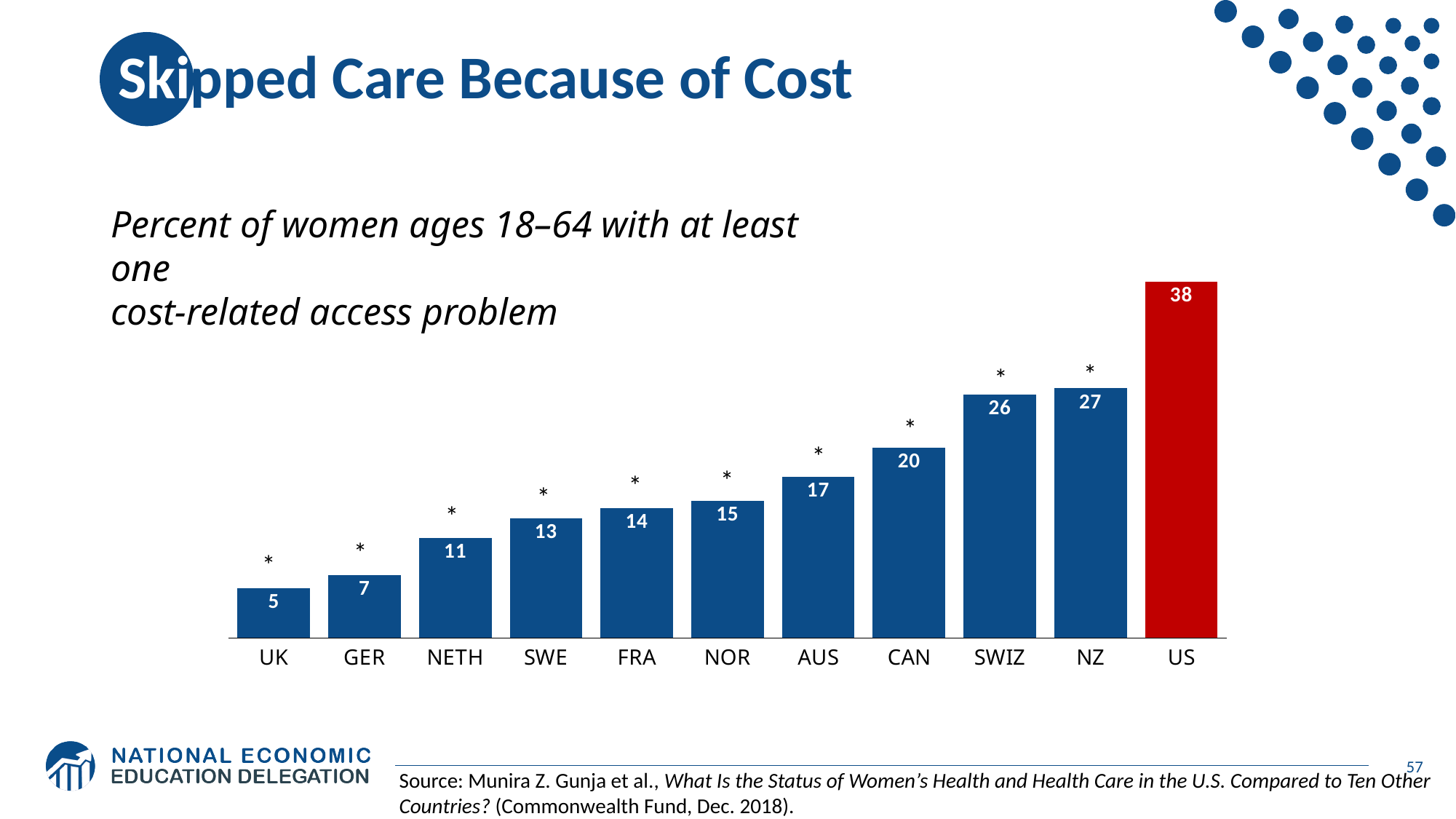
What is the difference between the values for SWIZ and AUS? 9 What is the value for the US? 38 Do the values rise or fall from left to right across the x axis? Rise What is the difference between the values for the US and NZ? 11 What kind of chart is shown on the slide? Bar chart What is the value for Germany (GER)? 7 How many countries are shown in the chart? 11 What is the value for Canada (CAN)? 20 Which country has the lowest value? UK Which country has the highest value? US Which has a larger value, NETH or SWE? SWE Which has a larger value, FRA or NOR? NOR